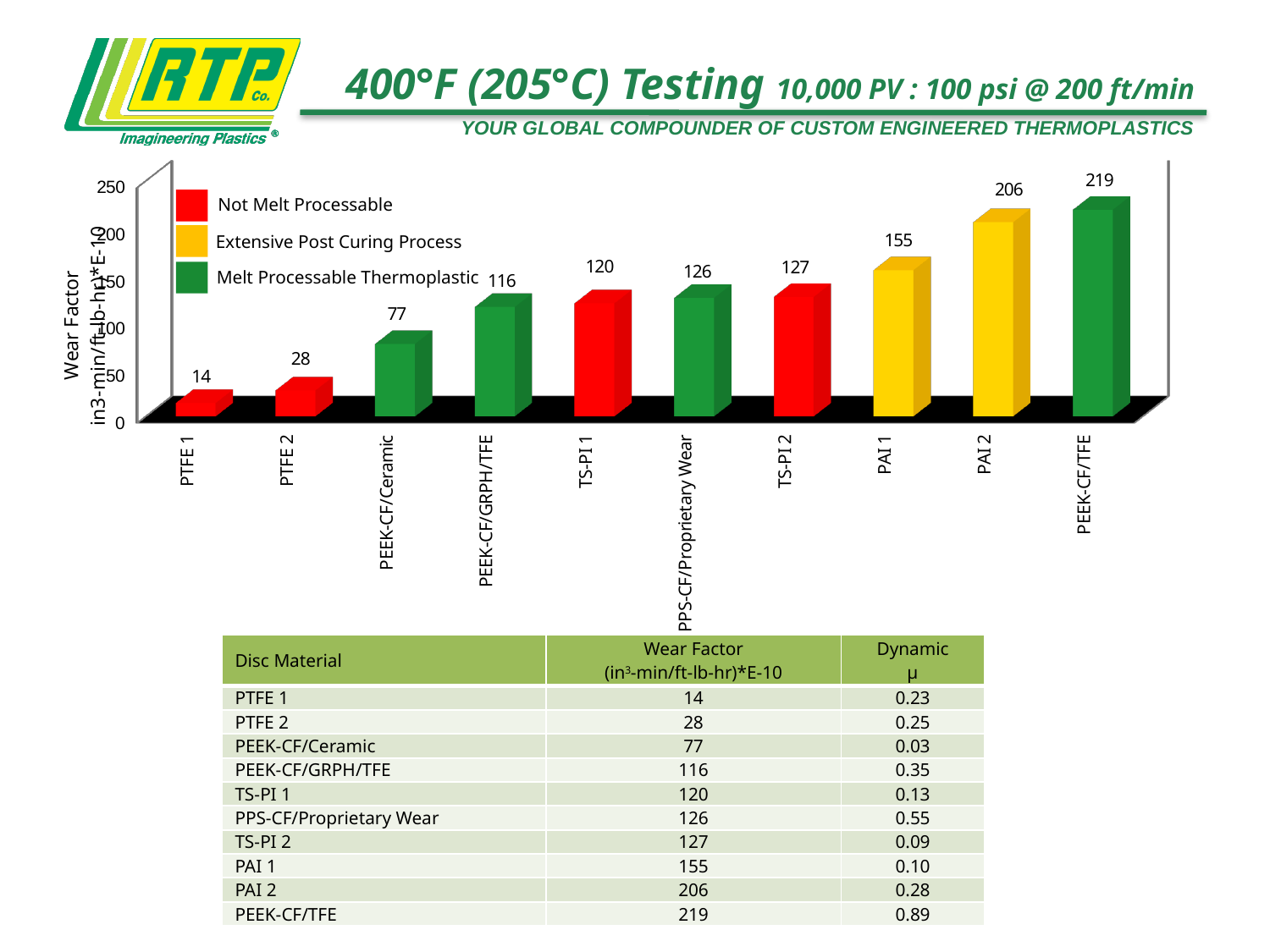
Which legend category is shown in red? Not Melt Processable What is the wear factor value shown for PEEK-CF/Ceramic? 77 What is the difference between the wear factor of PAI 2 and PAI 1? 51 Is the wear factor for PAI 2 greater or less than 200? greater Which has a higher wear factor, TS-PI 1 or PEEK-CF/GRPH/TFE? TS-PI 1 Do the wear factor values rise or fall from left to right across the chart? Rise Which material has the highest wear factor in the chart? PEEK-CF/TFE What kind of chart is shown on the slide? Bar chart How many categories does the chart legend list? 3 What is the wear factor value shown for PAI 1? 155 How many materials are plotted in the chart? 10 Which material has the lowest wear factor in the chart? PTFE 1